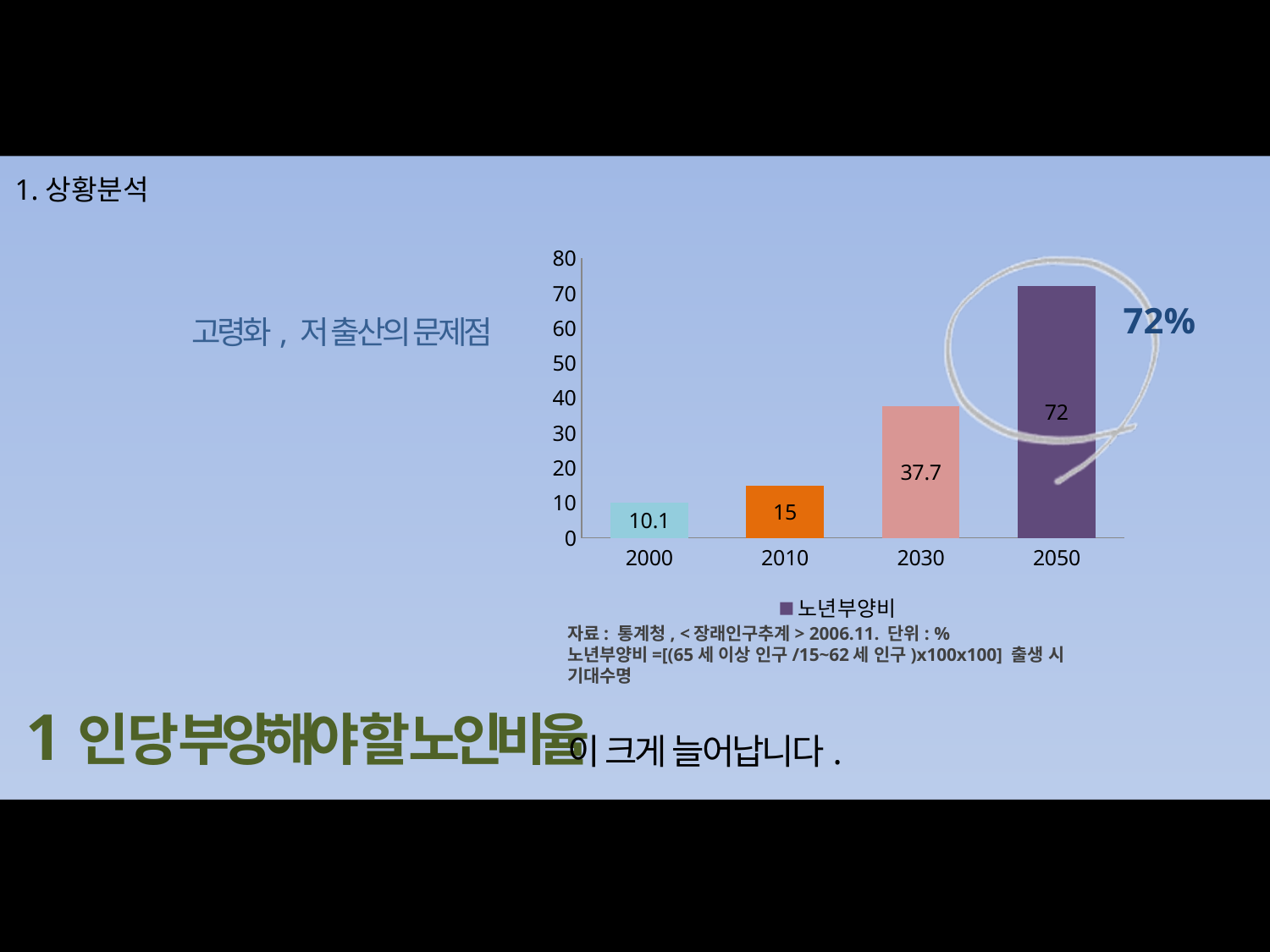
What is the difference between the values for 2050 and 2030? 34.3 Which is larger, the value for 2030 or the value for 2010? 2030 How many years are shown on the x axis? 4 What is the value for 2030? 37.7 What is the value for 2010? 15 What is the value for 2050? 72 Which year has the highest value? 2050 Do the values rise or fall from 2000 to 2050? rise What is the value for 2000? 10.1 What kind of chart is shown? bar chart What is the difference between the values for 2010 and 2000? 4.9 Which year has the lowest value? 2000